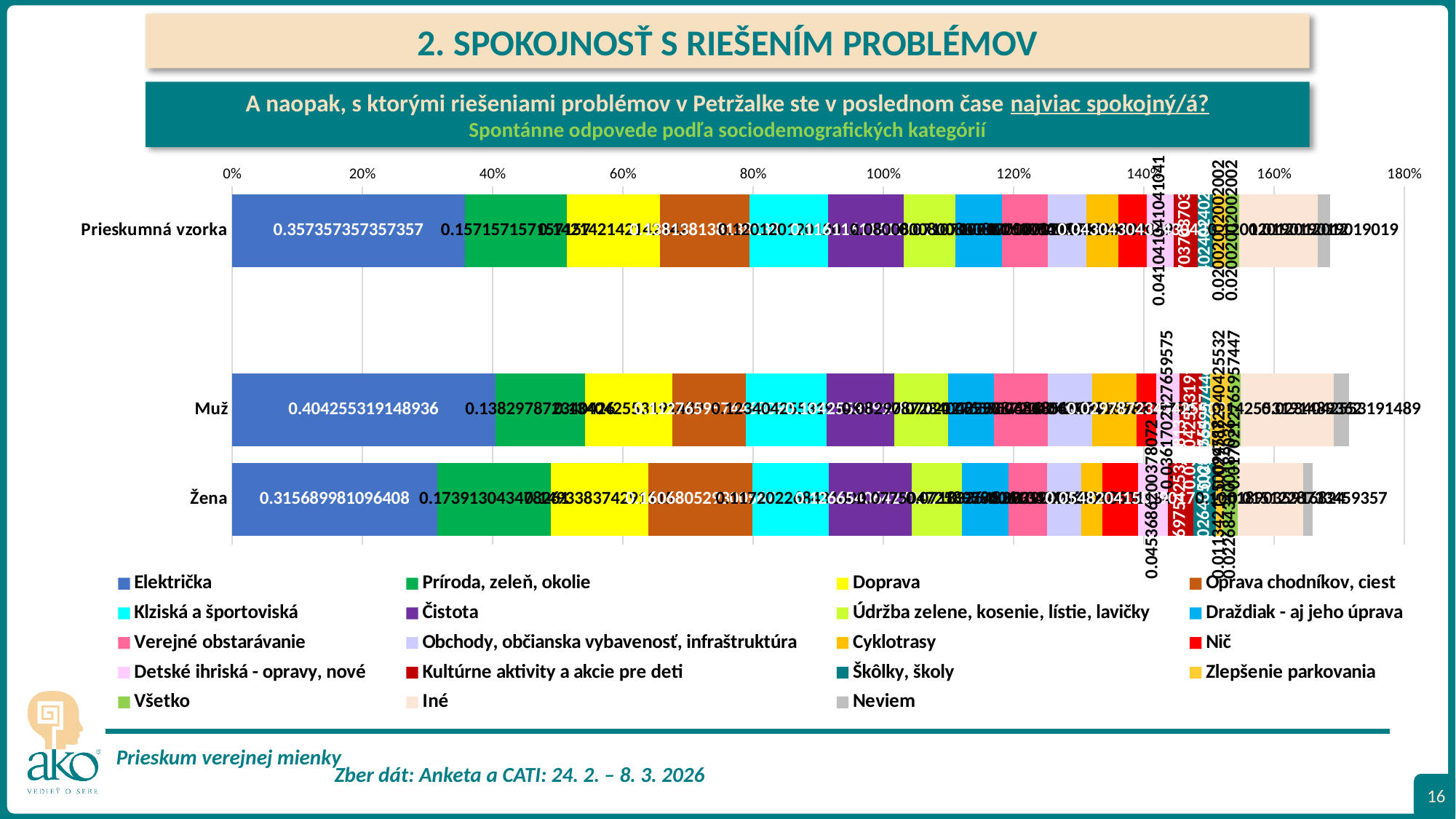
How many series does the chart legend list? 19 Which has the larger Električka value, Muž or Žena? Muž How many categories (rows) are plotted on the chart? 3 What kind of chart is shown on the slide? bar chart What is the Električka value for Muž? 0.404255319148936 What is the Električka value for Prieskumná vzorka? 0.357357357357357 Is the Električka value for Žena greater or less than 40%? less Which series is listed first in the chart legend? Električka What is the Električka value for Žena? 0.315689981096408 What is the maximum value shown on the horizontal axis? 180% Which category has the highest Električka value? Muž Which category has the lowest Električka value? Žena